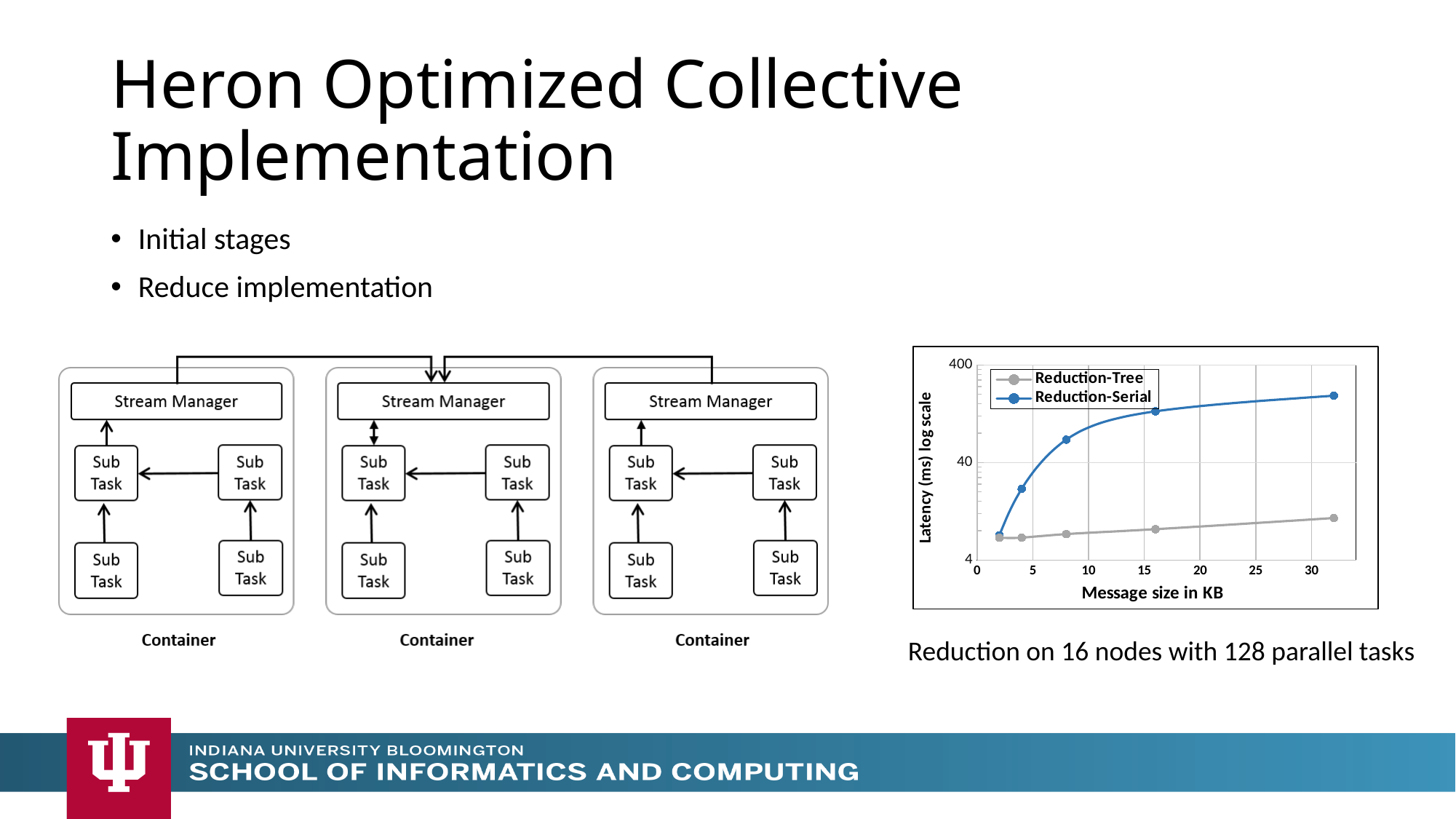
Is the latency of Reduction-Serial at 32 KB greater or less than 40? greater Which series has the lowest latency at 32 KB? Reduction-Tree Is the latency of Reduction-Tree at 32 KB greater or less than 40? less What is the x-axis title of the latency chart? Message size in KB How many data points are plotted for the Reduction-Serial series? 5 Does the latency of Reduction-Serial rise or fall as message size increases? rise How many series does the legend of the latency chart list? 2 Is the latency of Reduction-Serial at 4 KB greater or less than 40? less What are the names of the two series in the latency chart's legend? Reduction-Tree and Reduction-Serial What kind of chart is shown on the right side of the slide? line chart At a message size of 16 KB, which series has the higher latency, Reduction-Tree or Reduction-Serial? Reduction-Serial Does the latency of Reduction-Tree rise or fall as message size increases? rise